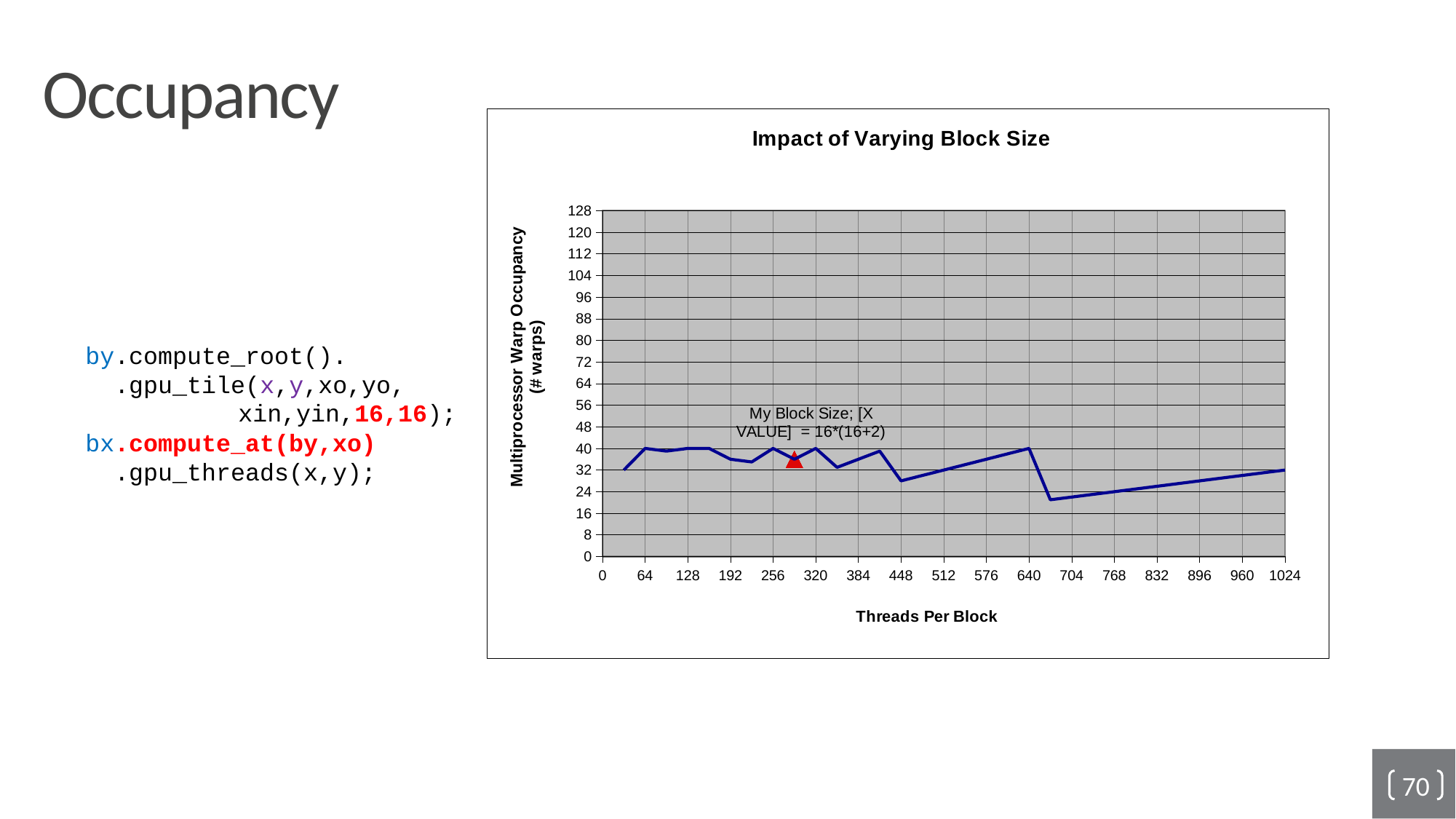
Is the warp occupancy at 704 threads per block greater or less than 32? less Which has the higher warp occupancy: 640 threads per block or 704 threads per block? 640 threads per block What kind of chart is shown on the slide? line chart Is the warp occupancy at 64 threads per block greater or less than 32? greater What is the title of the chart? Impact of Varying Block Size Is the warp occupancy at 448 threads per block greater or less than 24? greater Which has the higher warp occupancy: 256 threads per block or 448 threads per block? 256 threads per block Between 704 and 1024 threads per block, does the warp occupancy rise or fall? rise What is the label of the x axis of the chart? Threads Per Block